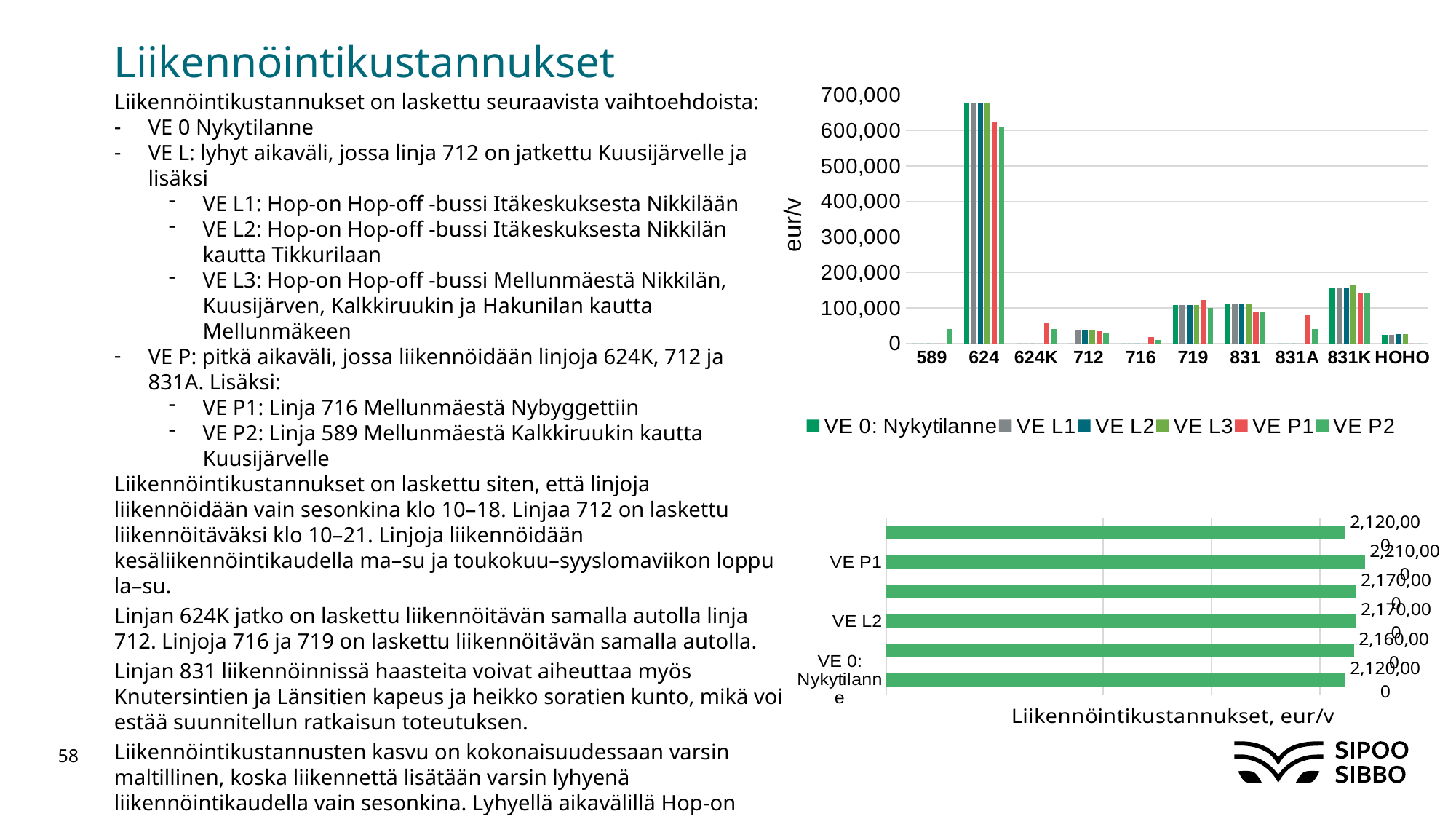
In the bottom chart, what is the value for VE 0: Nykytilanne? 2,120,000 In the top chart, which category has the highest values? 624 In the top chart, is the VE P1 value for 624K greater or less than 100,000? less How many series does the legend of the top chart list? 6 What kind of chart is the top chart on the slide? bar chart In the bottom chart, what is the value for VE P1? 2,210,000 In the top chart, is the VE 0: Nykytilanne value for 624 greater or less than 600,000? greater How many categories are shown on the x axis of the top chart? 10 What is the y-axis label of the top chart? eur/v In the top chart, is the VE L3 value for 831K greater or less than 100,000? greater In the bottom chart, what is the difference between the values for VE P1 and VE 0: Nykytilanne? 90,000 In the bottom chart, what is the value for VE L2? 2,170,000